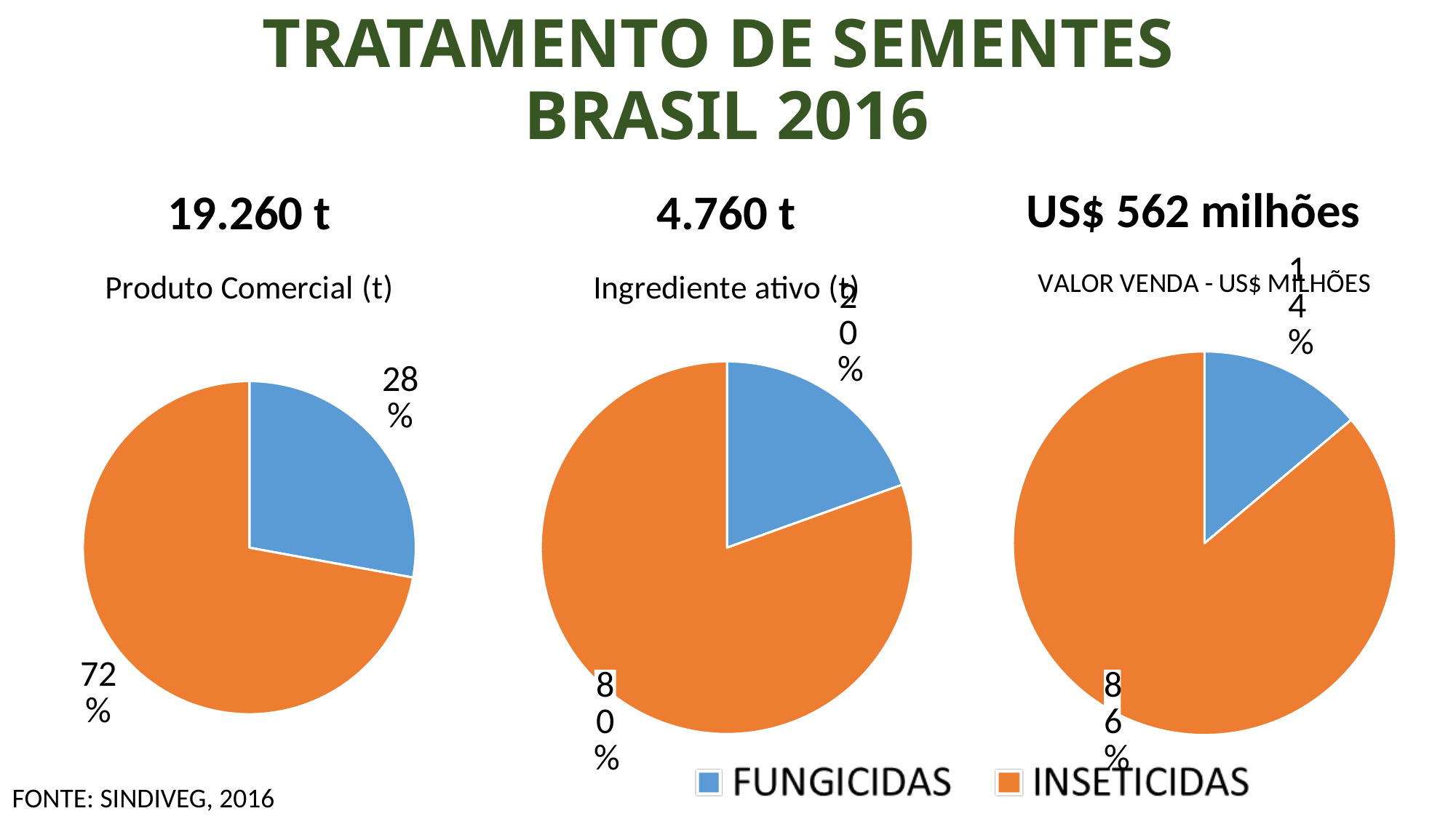
In the 'Ingrediente ativo (t)' pie chart, what share is labelled for FUNGICIDAS? 20% In the 'Produto Comercial (t)' pie chart, what share is labelled for FUNGICIDAS? 28% How many series does the shared legend list? 2 What kind of chart is used for 'Produto Comercial (t)'? Pie chart In the legend, which colour represents FUNGICIDAS? Blue In the 'Produto Comercial (t)' pie chart, what share is labelled for INSETICIDAS? 72% In the 'Produto Comercial (t)' pie chart, which category has the largest slice? INSETICIDAS In the 'Ingrediente ativo (t)' pie chart, what is the difference in percentage points between the INSETICIDAS and FUNGICIDAS slices? 60 In the 'VALOR VENDA - US$ MILHÕES' pie chart, which category has the smallest slice? FUNGICIDAS